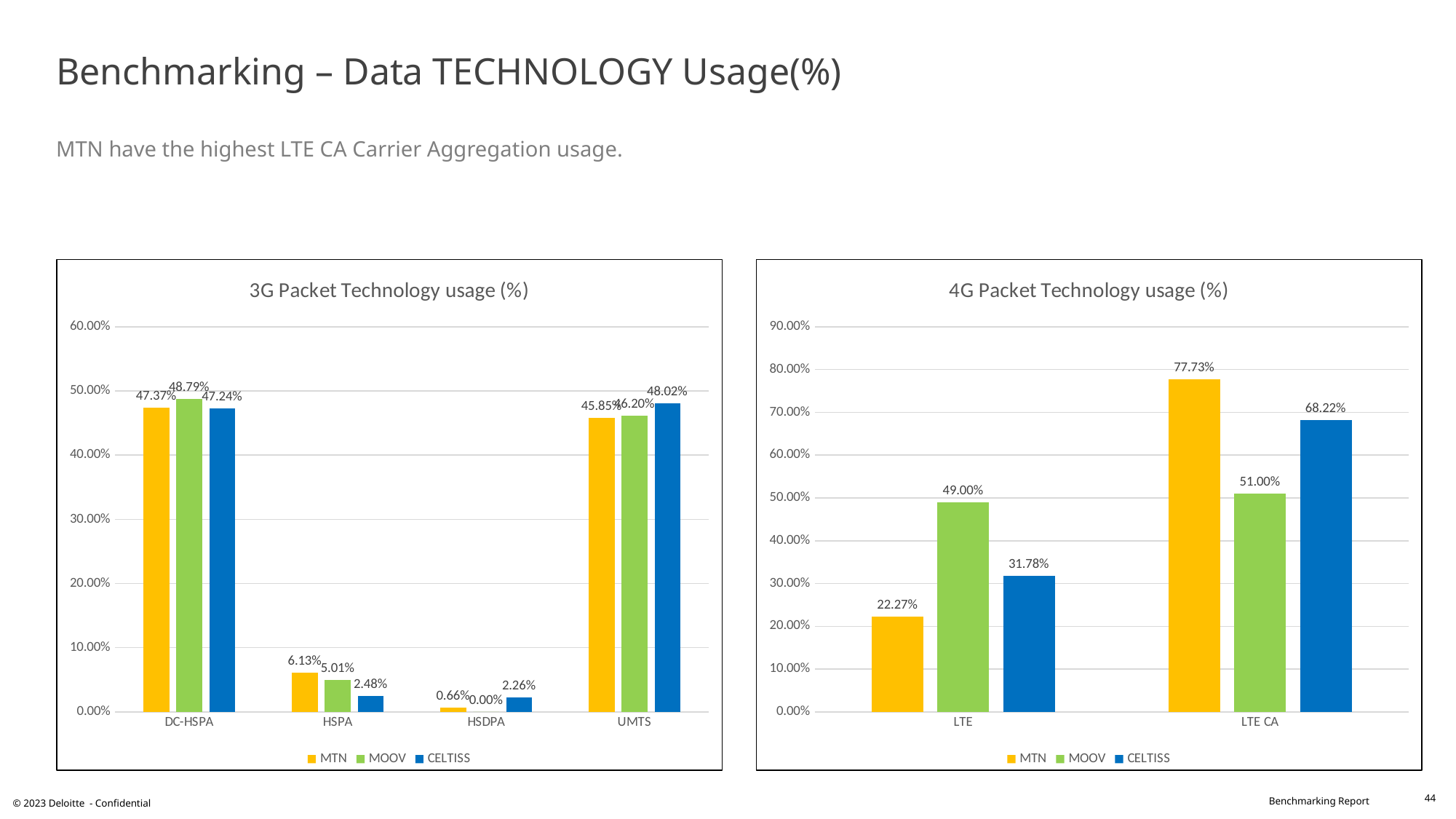
How many categories are shown on the x axis of the 3G Packet Technology usage (%) chart? 4 What type of chart is the 3G Packet Technology usage (%) chart? Bar chart In the 4G Packet Technology usage (%) chart, what is the value for MTN at LTE CA? 77.73% In the 4G Packet Technology usage (%) chart, which operator has the lowest value at LTE CA? MOOV In the 3G Packet Technology usage (%) chart, what is the value for MOOV at HSDPA? 0.00% In the 3G Packet Technology usage (%) chart, which is larger at HSDPA: MTN or CELTISS? CELTISS In the 3G Packet Technology usage (%) chart, what is the difference between MTN and CELTISS at HSPA? 3.65% In the 3G Packet Technology usage (%) chart, what is the value for CELTISS at HSPA? 2.48% In the 4G Packet Technology usage (%) chart, what is the difference between MTN's LTE CA value and MTN's LTE value? 55.46% In the 4G Packet Technology usage (%) chart, is the value for CELTISS at LTE greater or less than 30.00%? greater In the 4G Packet Technology usage (%) chart, which operator has the highest value at LTE? MOOV How many series does the legend of the 4G Packet Technology usage (%) chart list? 3